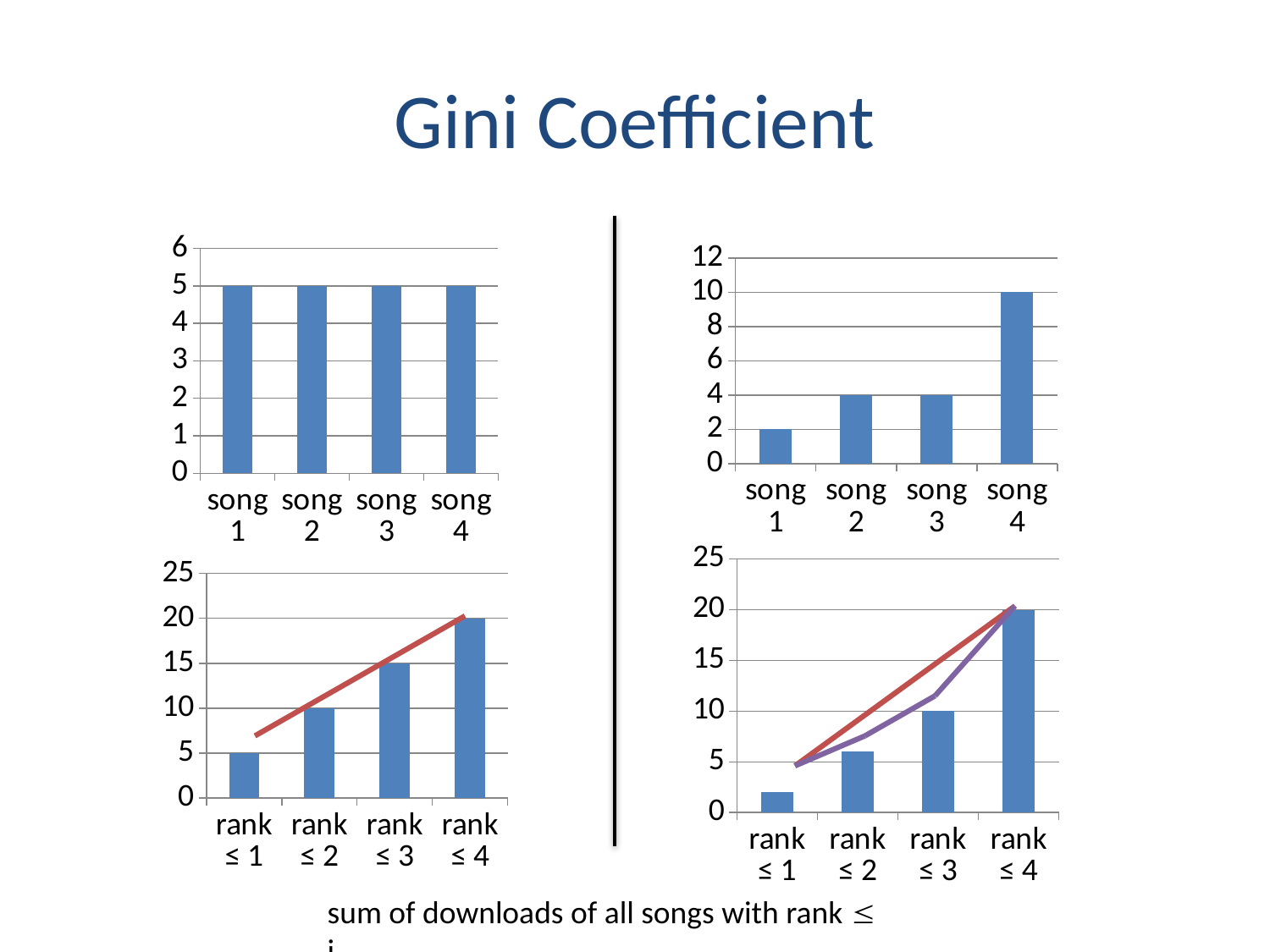
In the top-right bar chart, which song has the highest value? song 4 In the top-right bar chart, what is the value for song 4? 10 What is the title of the slide containing these charts? Gini Coefficient In the top-left bar chart, what is the value for song 2? 5 How many categories are shown in the top-left bar chart? 4 In the bottom-right chart, is the bar value for rank ≤ 1 greater or less than 5? less In the top-right bar chart, which song has the lowest value? song 1 In the bottom-left chart, what is the bar value for rank ≤ 3? 15 In the bottom-right chart, what is the bar value for rank ≤ 4? 20 In the bottom-left chart, do the bar values rise or fall from rank ≤ 1 to rank ≤ 4? rise In the top-right bar chart, what is the difference between the values for song 4 and song 1? 8 In the top-right bar chart, what is the value for song 1? 2